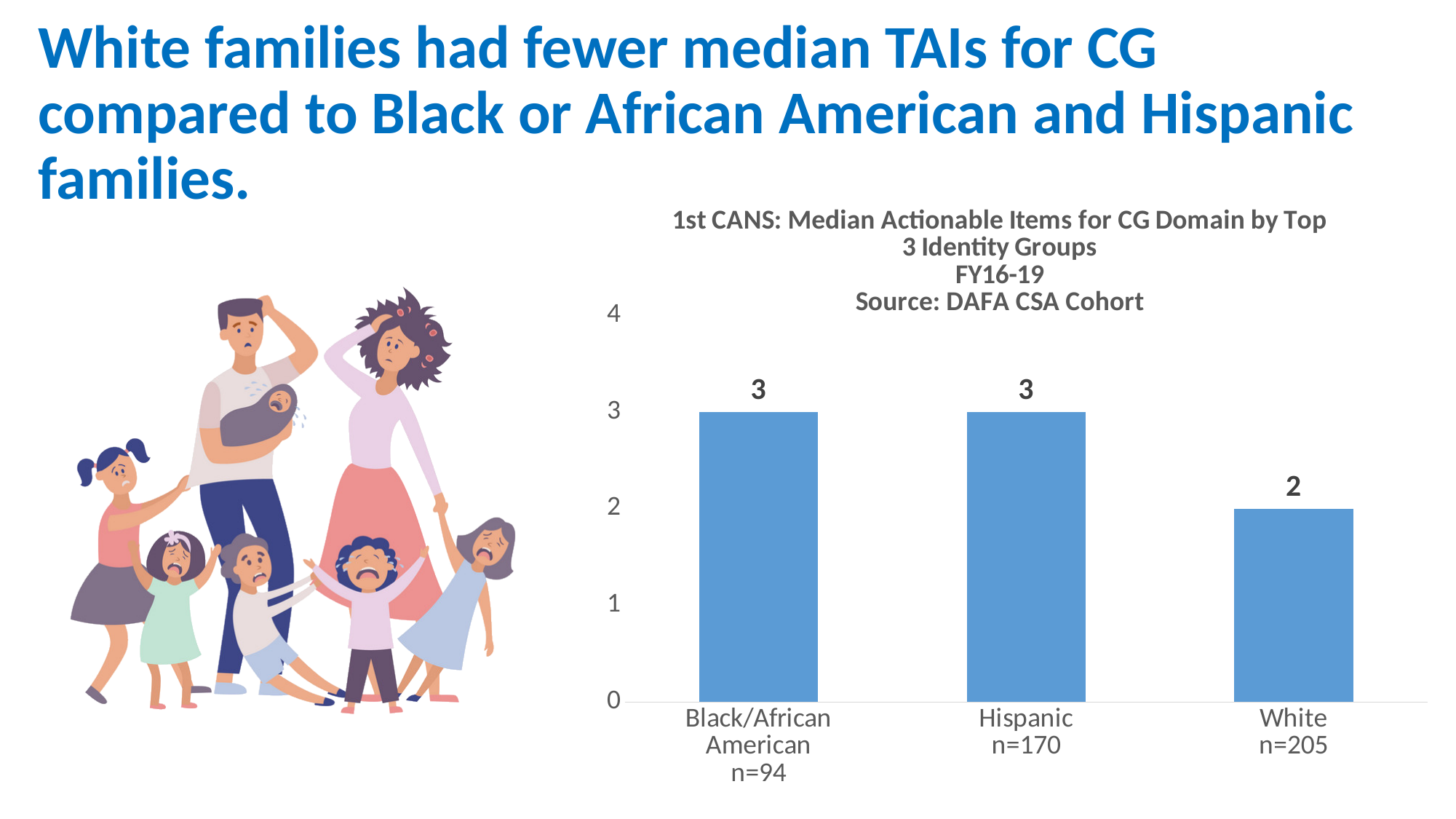
Do the values rise or fall from left to right across the chart? Fall How many identity groups are shown in the chart? 3 Which is larger, the median actionable items for Black/African American families or for White families? Black/African American What is the difference between the median actionable items for Hispanic families and White families? 1 Is the value for White families greater or less than 3? less What is the median number of actionable items for the CG domain for Black/African American families? 3 Which identity group has the lowest median number of actionable items for the CG domain? White What kind of chart is shown on the slide? Bar chart What is the median number of actionable items for the CG domain for Hispanic families? 3 What is the median number of actionable items for the CG domain for White families? 2 What is the sample size (n) for the White group shown on the x axis? n=205 What is the sample size (n) for the Hispanic group shown on the x axis? n=170